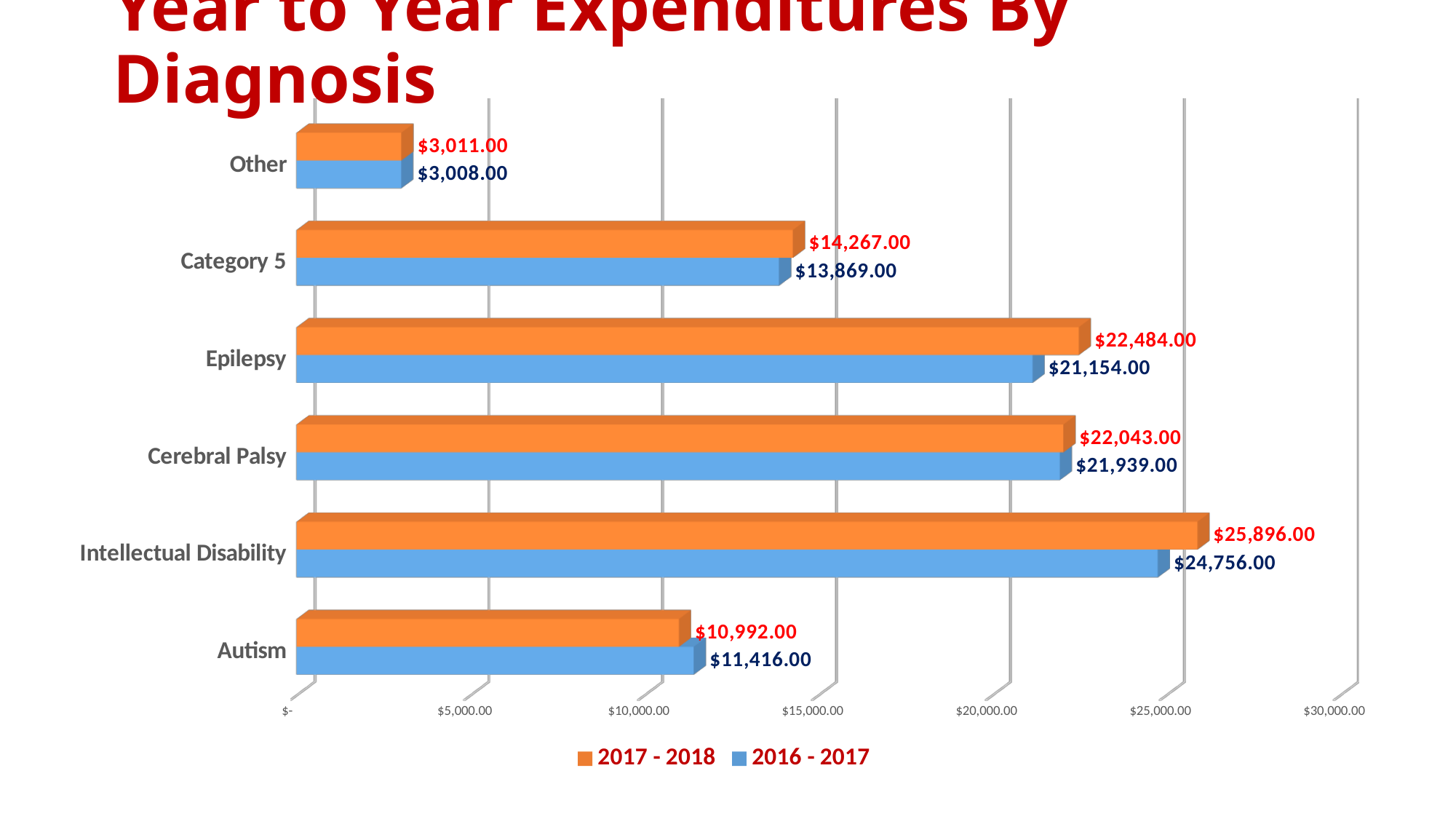
What is the difference between the 2017 - 2018 and 2016 - 2017 expenditures for Intellectual Disability? $1,140.00 What colour represents the 2017 - 2018 series? orange Which diagnosis has the highest 2017 - 2018 expenditure? Intellectual Disability What kind of chart is shown on the slide? bar chart What is the 2016 - 2017 expenditure for Autism? $11,416.00 What is the 2017 - 2018 expenditure for Epilepsy? $22,484.00 What is the difference between the 2016 - 2017 and 2017 - 2018 expenditures for Autism? $424.00 How many series does the legend list? 2 Which diagnosis has the lowest 2016 - 2017 expenditure? Other Is the 2017 - 2018 expenditure for Category 5 greater or less than $15,000.00? less For Autism, which series has the larger expenditure, 2016 - 2017 or 2017 - 2018? 2016 - 2017 How many diagnosis categories are shown on the chart? 6